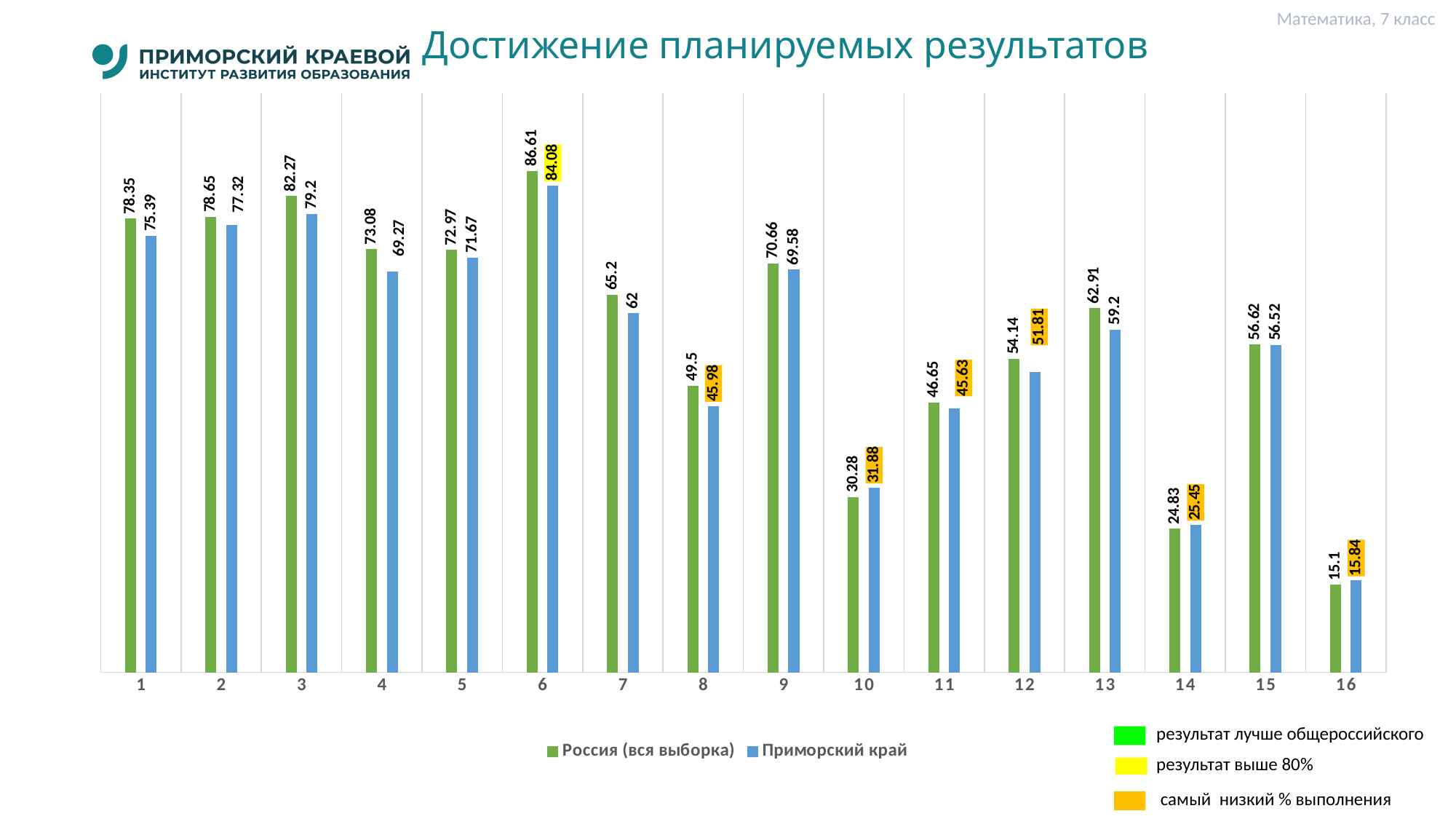
How many series does the chart legend list? 2 Which category has the lowest value for Россия (вся выборка)? 16 For category 13, which series has the larger value: Россия (вся выборка) or Приморский край? Россия (вся выборка) What is the value for Приморский край for category 10? 31.88 Which category has the highest value for Приморский край? 6 What is the value for Приморский край for category 3? 79.2 Which series is shown in blue in the chart legend? Приморский край What is the difference between the Россия (вся выборка) and Приморский край values for category 4? 3.81 What kind of chart is shown on the slide? Bar chart What is the value for Россия (вся выборка) for category 6? 86.61 How many categories are shown on the x axis? 16 For category 14, which series has the larger value: Россия (вся выборка) or Приморский край? Приморский край